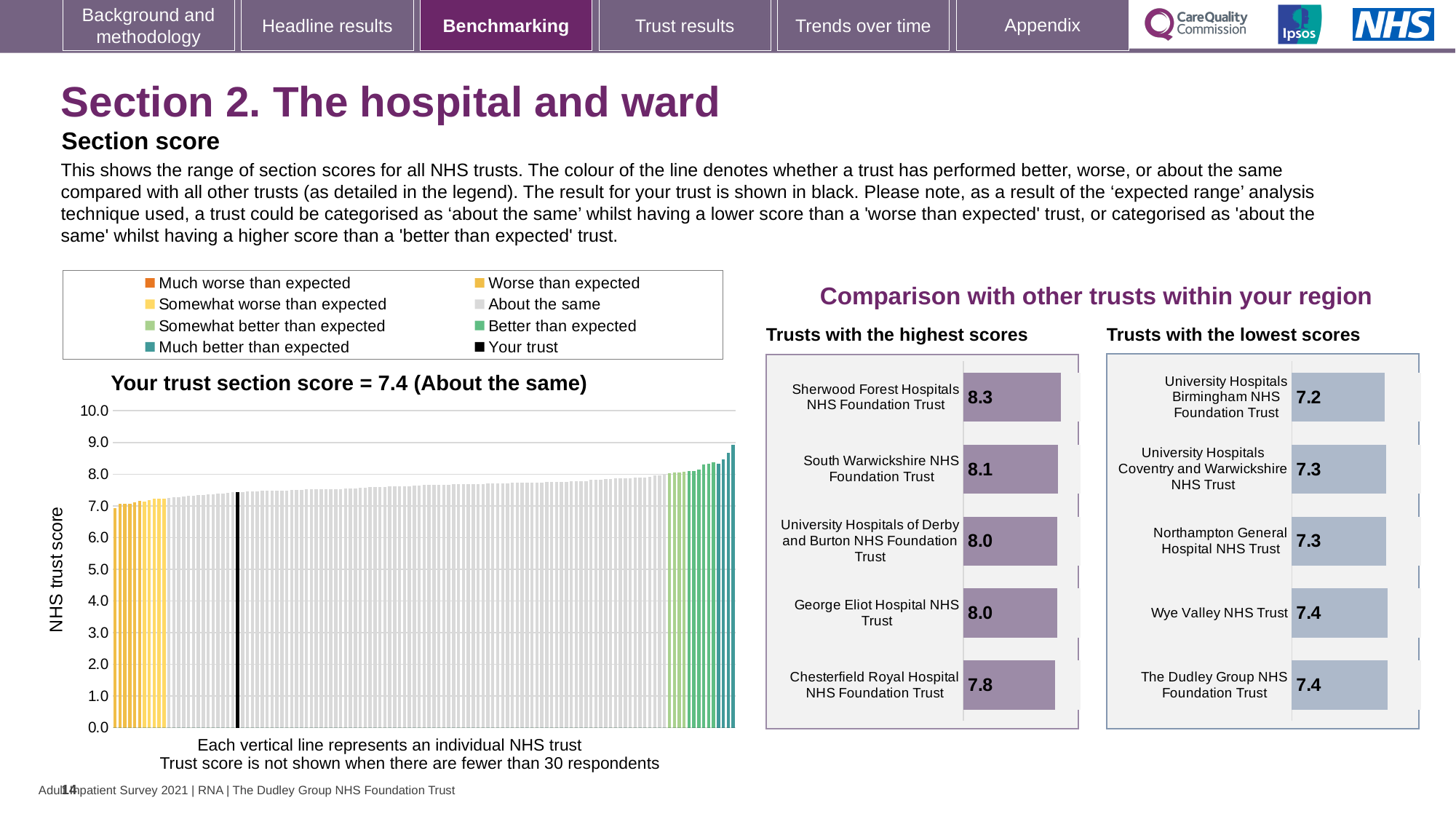
In the 'Your trust section score' chart, what is the section score for your trust? 7.4 In the 'Trusts with the lowest scores' chart, which trust has the lowest score? University Hospitals Birmingham NHS Foundation Trust In the 'Your trust section score' chart, is the value for your trust greater or less than 8.0? less In the 'Trusts with the lowest scores' chart, how many trusts are shown? 5 In the 'Trusts with the lowest scores' chart, which is larger: the score for Northampton General Hospital NHS Trust or the score for Wye Valley NHS Trust? Wye Valley NHS Trust In the 'Your trust section score' chart, how many entries does the legend list? 8 In the 'Trusts with the highest scores' chart, which trust has the lowest score? Chesterfield Royal Hospital NHS Foundation Trust In the 'Your trust section score' chart, do the trust scores rise or fall from left to right along the x axis? rise In the 'Trusts with the highest scores' chart, what is the difference between the scores of Sherwood Forest Hospitals NHS Foundation Trust and Chesterfield Royal Hospital NHS Foundation Trust? 0.5 In the 'Trusts with the highest scores' chart, what is the score for Sherwood Forest Hospitals NHS Foundation Trust? 8.3 In the 'Your trust section score' chart, what kind of chart is shown? bar chart In the 'Your trust section score' chart, what is the label on the vertical axis? NHS trust score